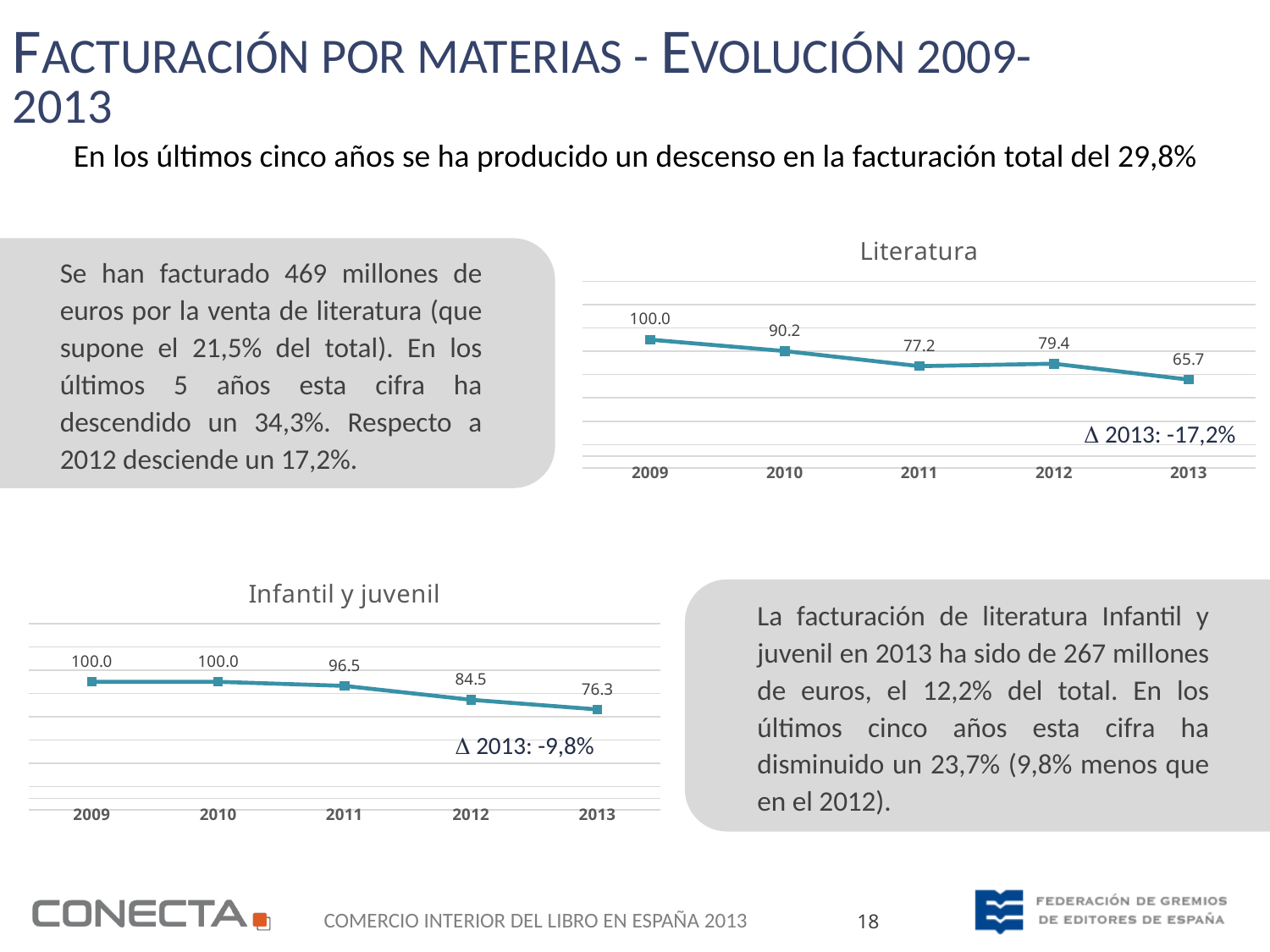
In the 'Literatura' chart, which is larger, the value for 2011 or the value for 2012? 2012 What is the title of the chart in the lower left of the slide? Infantil y juvenil In the 'Literatura' chart, what is the difference between the 2009 value and the 2013 value? 34.3 In the 'Infantil y juvenil' chart, how many years are plotted? 5 In the 'Infantil y juvenil' chart, what is the difference between the 2011 value and the 2013 value? 20.2 In the 'Infantil y juvenil' chart, do the values rise or fall from 2011 to 2013? Fall In the 'Infantil y juvenil' chart, what is the value for 2013? 76.3 In the 'Literatura' chart, which year has the lowest value? 2013 In the 'Literatura' chart, what is the value for 2011? 77.2 In the 'Literatura' chart, what is the value for 2013? 65.7 In the 'Infantil y juvenil' chart, what is the value for 2012? 84.5 What kind of chart is the 'Literatura' chart? Line chart